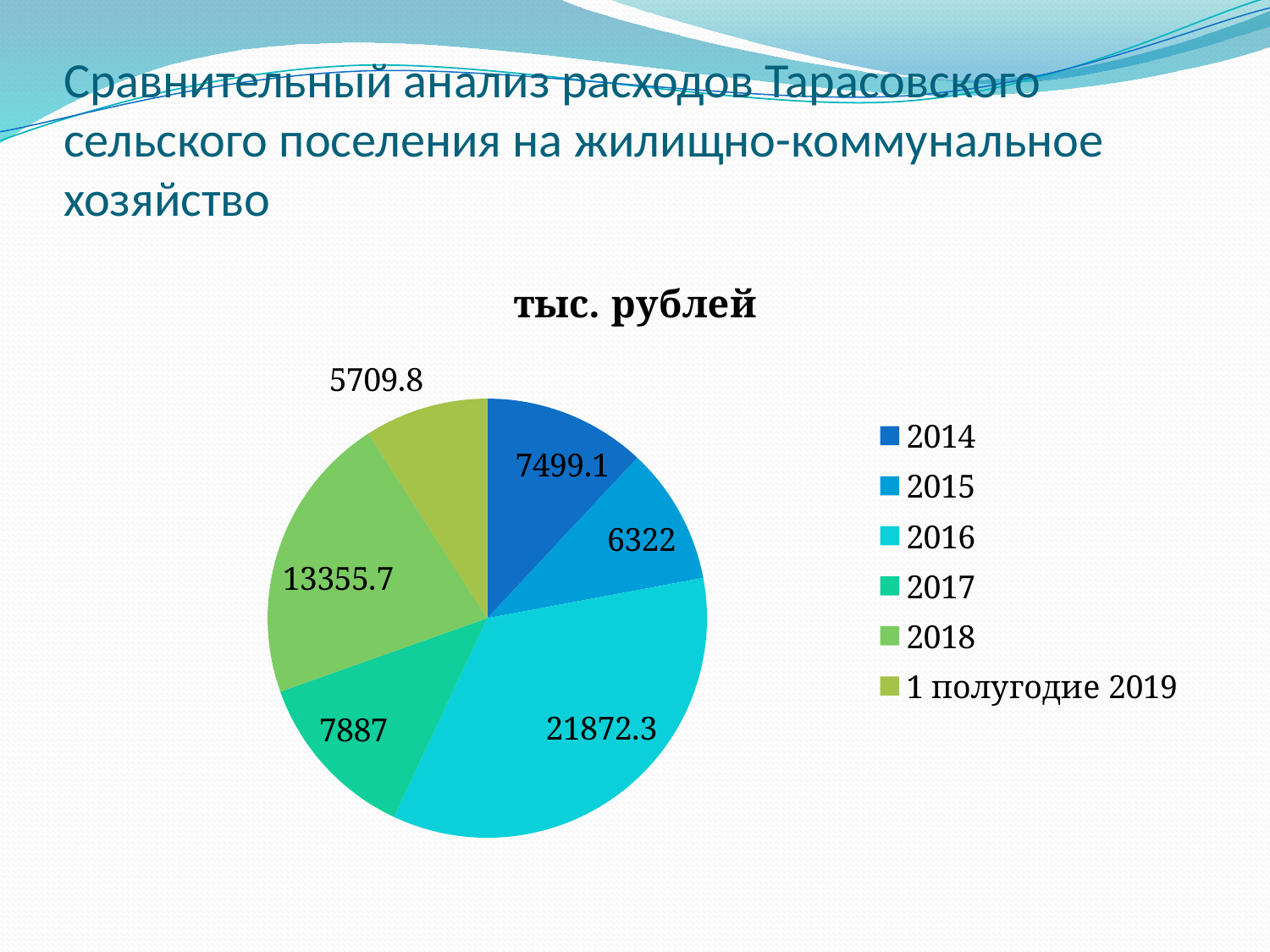
What type of chart is shown on the slide? Pie chart What is the difference between the values for 2016 and 2018? 8516.6 Which is larger, the value for 2014 or the value for 2015? 2014 What is the difference between the values for 2017 and 2015? 1565 What is the value for 2018 in the pie chart? 13355.7 What is the value for 2015 in the pie chart? 6322 What is the title of the pie chart? тыс. рублей How many slices does the pie chart have? 6 Which year has the largest slice in the pie chart? 2016 Which category has the smallest slice in the pie chart? 1 полугодие 2019 What is the value for 2016 in the pie chart? 21872.3 What is the value for 1 полугодие 2019 in the pie chart? 5709.8